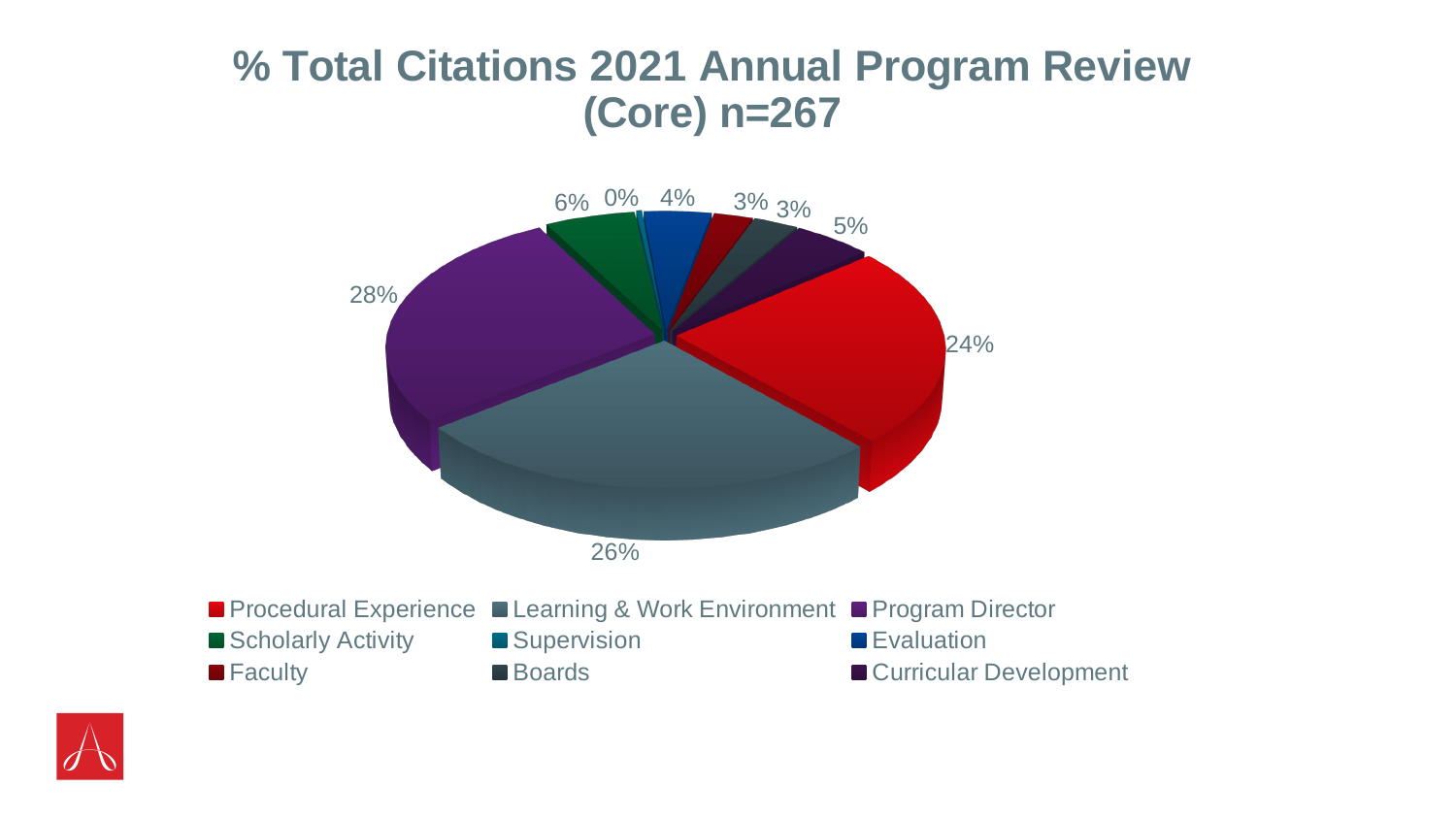
What is the difference in percentage points between Program Director and Procedural Experience? 4 What is the value of n stated in the chart title? 267 Which category has the largest share of total citations? Program Director How many categories are listed in the legend? 9 What type of chart is shown on the slide? pie chart What percentage of total citations is attributed to Program Director? 28% What percentage of total citations is attributed to Procedural Experience? 24% What percentage of total citations is attributed to Curricular Development? 5% What percentage of total citations is attributed to Learning & Work Environment? 26% Which category has the smallest share of total citations? Supervision What percentage of total citations is attributed to Scholarly Activity? 6% Which has a larger share of citations, Scholarly Activity or Evaluation? Scholarly Activity